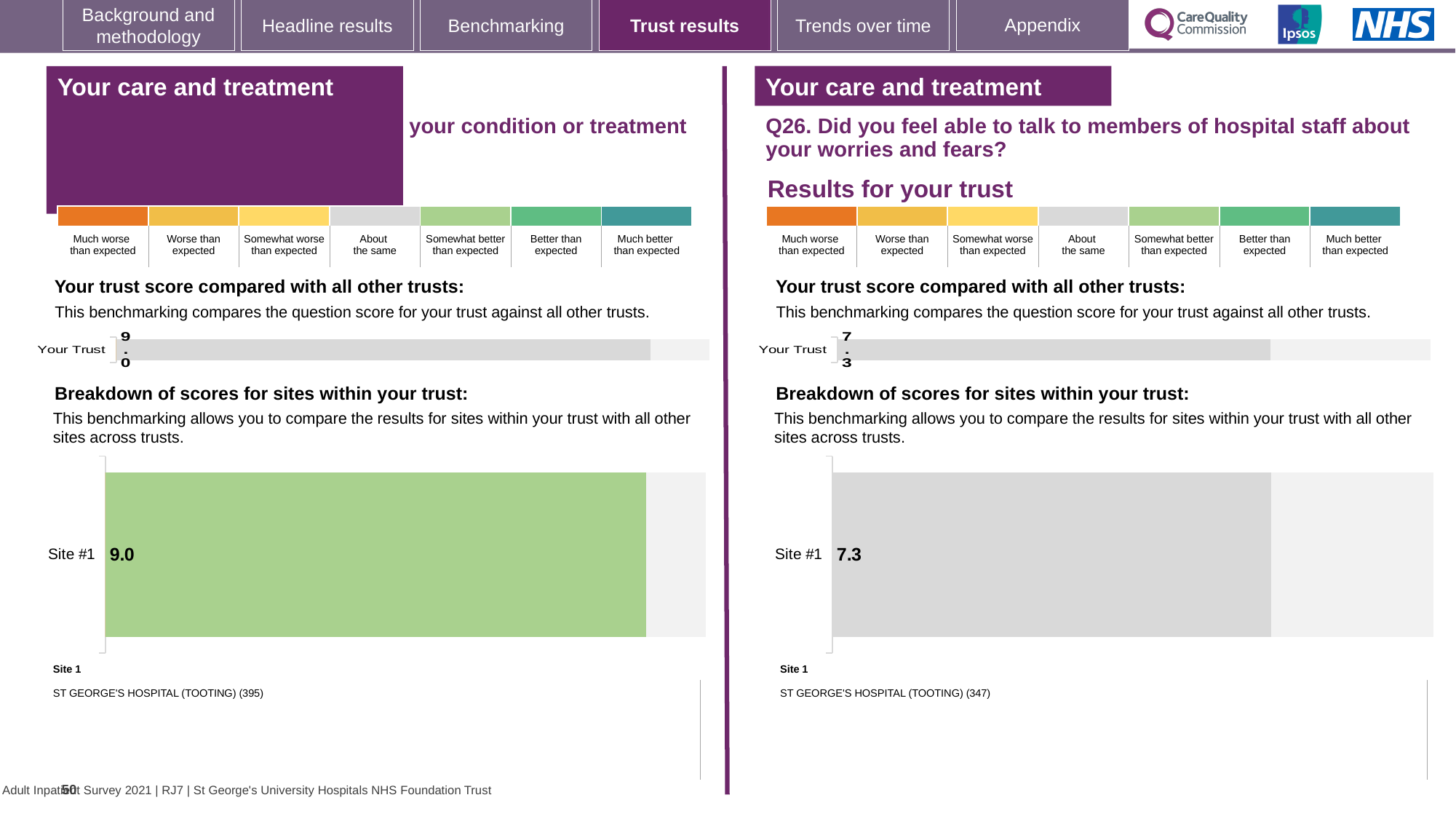
In the left-hand 'Breakdown of scores for sites within your trust' chart, what is the score for Site #1? 9.0 In the right-hand 'Breakdown of scores for sites within your trust' chart (Q26), what is the score for Site #1? 7.3 What is the difference between the Site #1 score on the left-hand side (9.0) and the Site #1 score on the right-hand side (7.3)? 1.7 What colour is the Site #1 bar in the left-hand breakdown chart? Green How many sites are shown in the right-hand 'Breakdown of scores for sites within your trust' chart? 1 What is the question number shown on the right-hand side of the slide? Q26 On the right-hand side of the slide (Q26), what is the score shown for 'Your Trust'? 7.3 Which is larger: the Site #1 score in the left-hand breakdown chart or the Site #1 score in the right-hand breakdown chart? Left-hand chart (9.0) On the left-hand side of the slide, what is the score shown for 'Your Trust'? 9.0 Is the 'Your Trust' score on the right-hand side of the slide greater or less than 9.0? less Which site name is listed as Site 1 under the right-hand breakdown chart? ST GEORGE'S HOSPITAL (TOOTING) (347) What type of chart is used to show the Site #1 score in the left-hand breakdown section? Bar chart